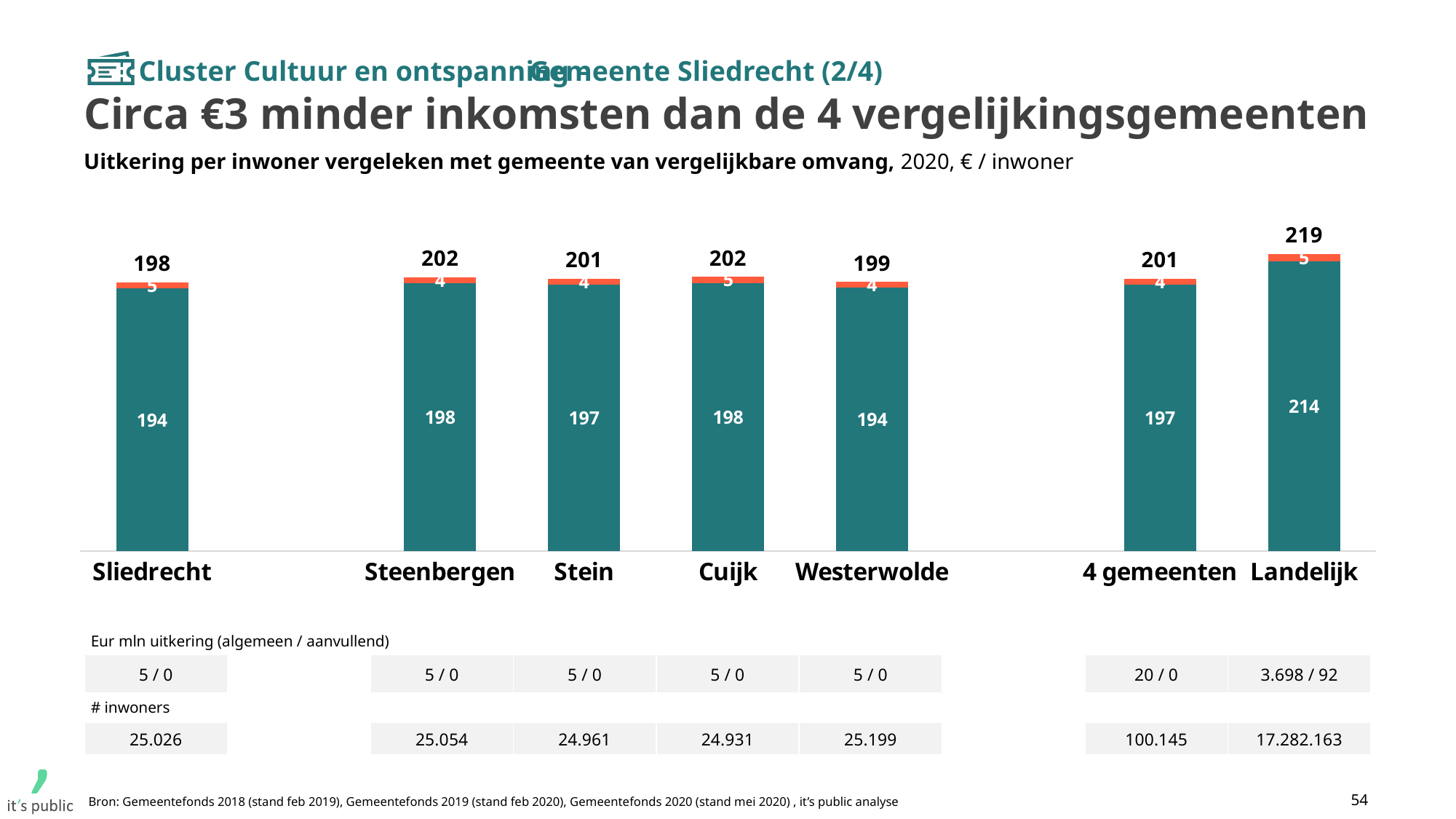
What is the total of the stacked bar for Stein (197 + 4)? 201 What is the total value shown above the bar for Sliedrecht? 198 What kind of chart is shown on the slide? Stacked bar chart Which category has the lowest total value? Sliedrecht Which category has the highest total value? Landelijk Which has a larger total value, Steenbergen or Westerwolde? Steenbergen What is the total value shown above the bar for 4 gemeenten? 201 What is the difference between the total for Landelijk and the total for Sliedrecht? 21 What is the difference between the total for 4 gemeenten and the total for Sliedrecht? 3 What is the value of the orange (upper) segment for Cuijk? 5 How many categories are shown on the x axis of the chart? 7 What is the value of the teal (lower) segment for Landelijk? 214